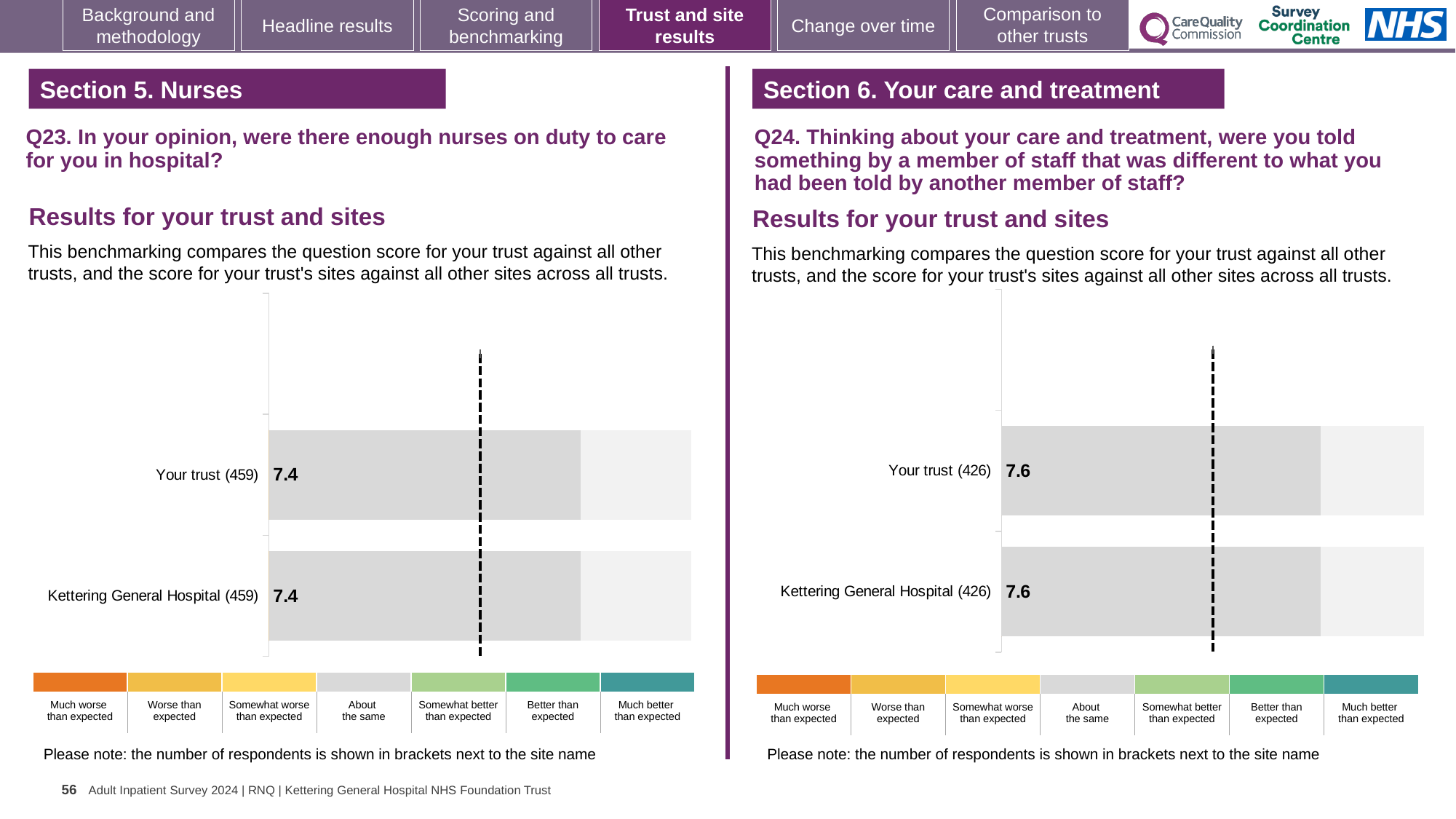
On the Q23 chart (left), what is the score for Your trust? 7.4 How many bars are plotted on the Q24 chart (right)? 2 What kind of chart is the Q23 chart (left)? Bar chart On the Q24 chart (right), what is the score for Kettering General Hospital? 7.6 On the Q24 chart (right), what is the score for Your trust? 7.6 On the Q23 chart (left), what is the score for Kettering General Hospital? 7.4 On the Q24 chart (right), what is the difference between the score for Your trust and the score for Kettering General Hospital? 0 How many bars are plotted on the Q23 chart (left)? 2 How many benchmark categories does the colour key below the Q24 chart (right) list? 7 On the Q23 chart (left), what is the difference between the score for Your trust and the score for Kettering General Hospital? 0 On the Q23 chart (left), how many respondents are shown in brackets for Your trust? 459 On the Q24 chart (right), how many respondents are shown in brackets for Kettering General Hospital? 426